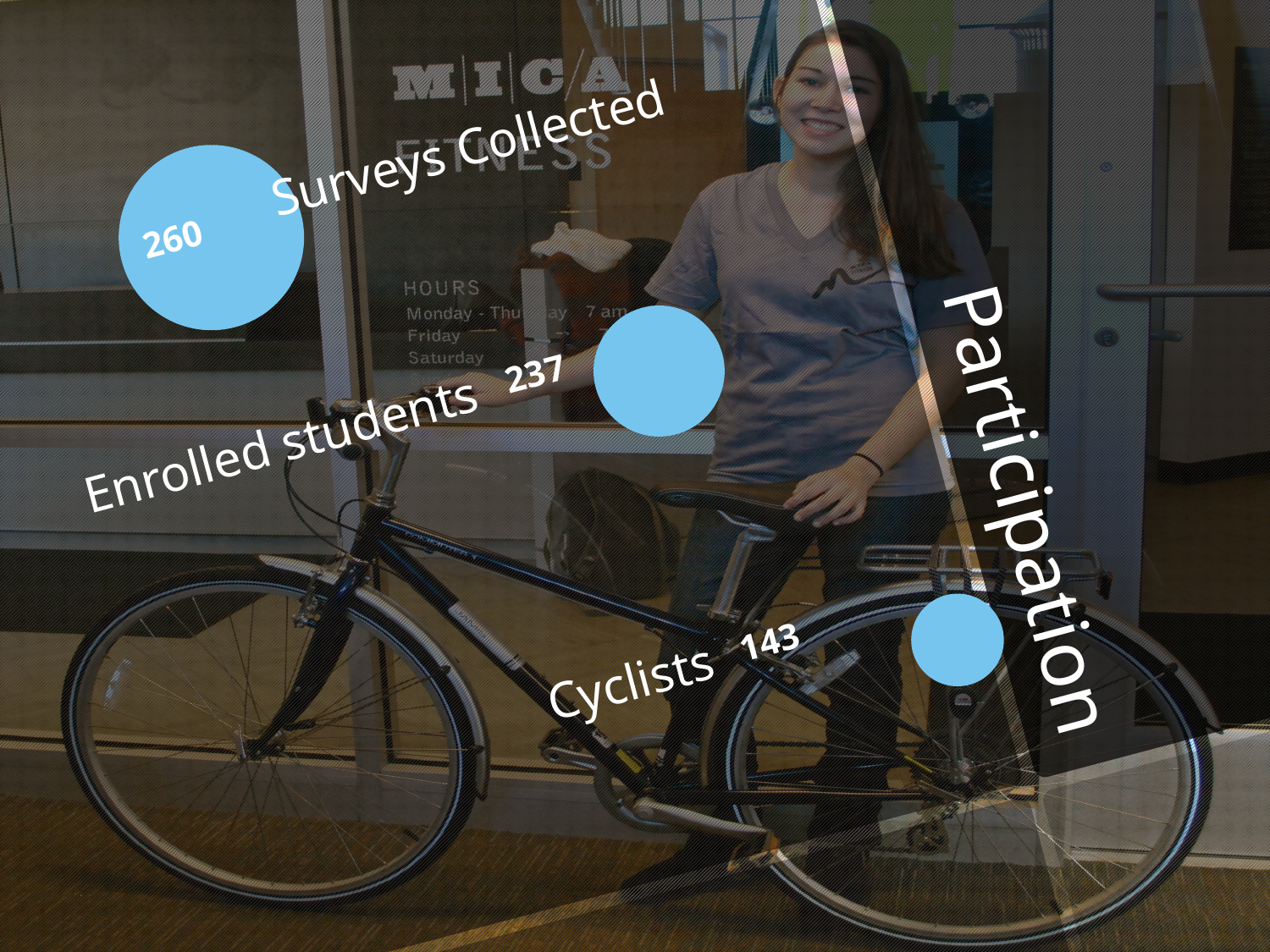
What is the value for Surveys Collected? 260 What is the value for Cyclists? 143 What is the difference between Surveys Collected and Cyclists? 117 What is the difference between Surveys Collected and Enrolled students? 23 Which is larger, Enrolled students or Cyclists? Enrolled students How many categories are shown in the chart? 3 Which category has the highest value? Surveys Collected Which category has the lowest value? Cyclists What is the value for Enrolled students? 237 What is the title of the chart? Participation What is the difference between Enrolled students and Cyclists? 94 What kind of chart is shown on the slide? Bubble chart